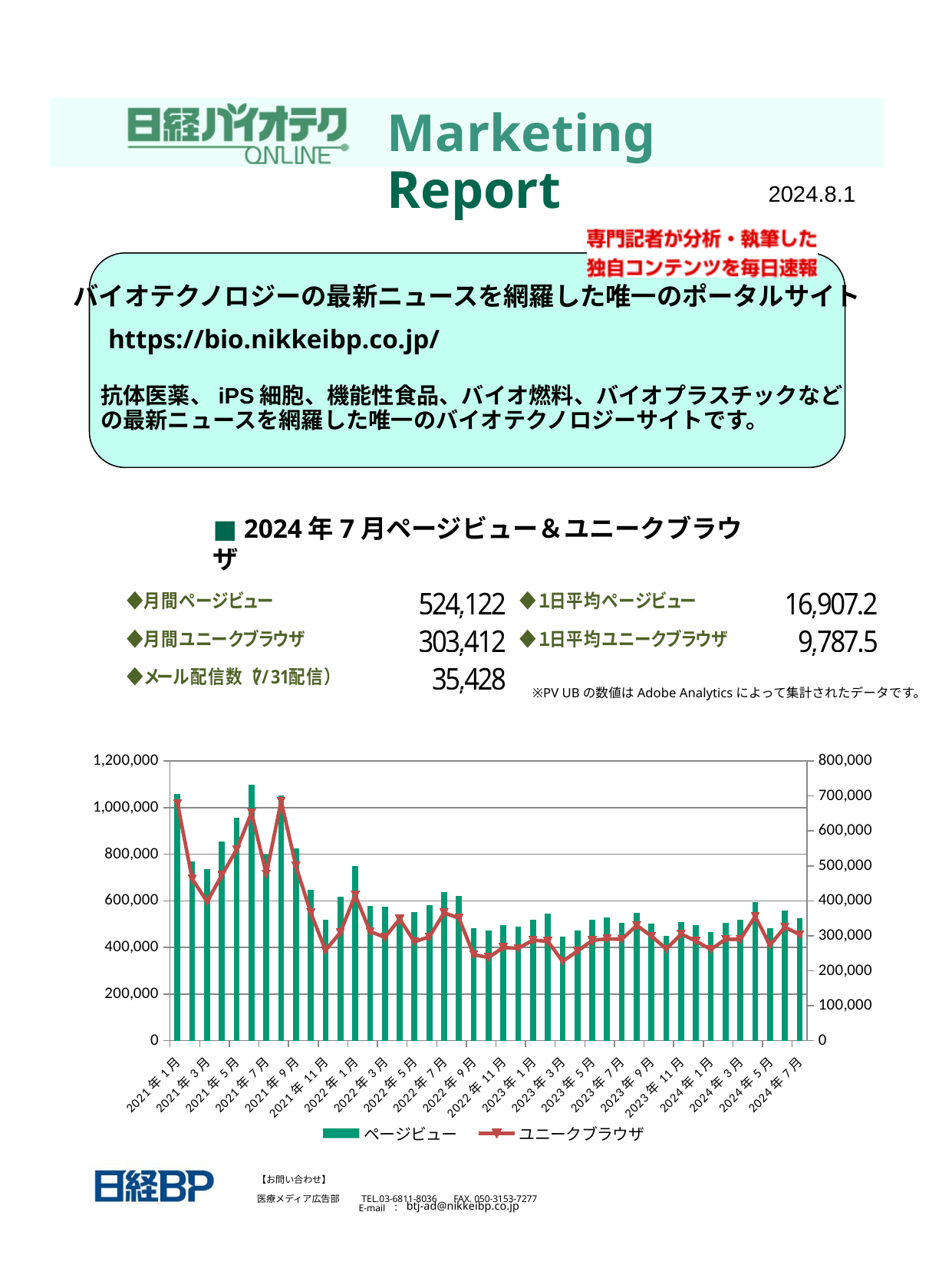
Is the ページビュー value for 2022年1月 greater or less than 600,000? greater Is the ユニークブラウザ value for 2021年1月 greater or less than 600,000 on the right axis? greater What are the two series named in the chart legend? ページビュー and ユニークブラウザ Is the ページビュー value for 2021年1月 greater or less than 1,000,000? greater What kind of chart is shown on the slide? A combined bar and line chart Which month has the larger ページビュー value, 2021年7月 or 2024年7月? 2021年7月 How many series does the chart legend list? 2 Which series is drawn as bars in the chart? ページビュー In which month is the ページビュー bar highest? 2021年6月 Overall, do the ページビュー values rise or fall from 2021年1月 to 2024年7月? fall